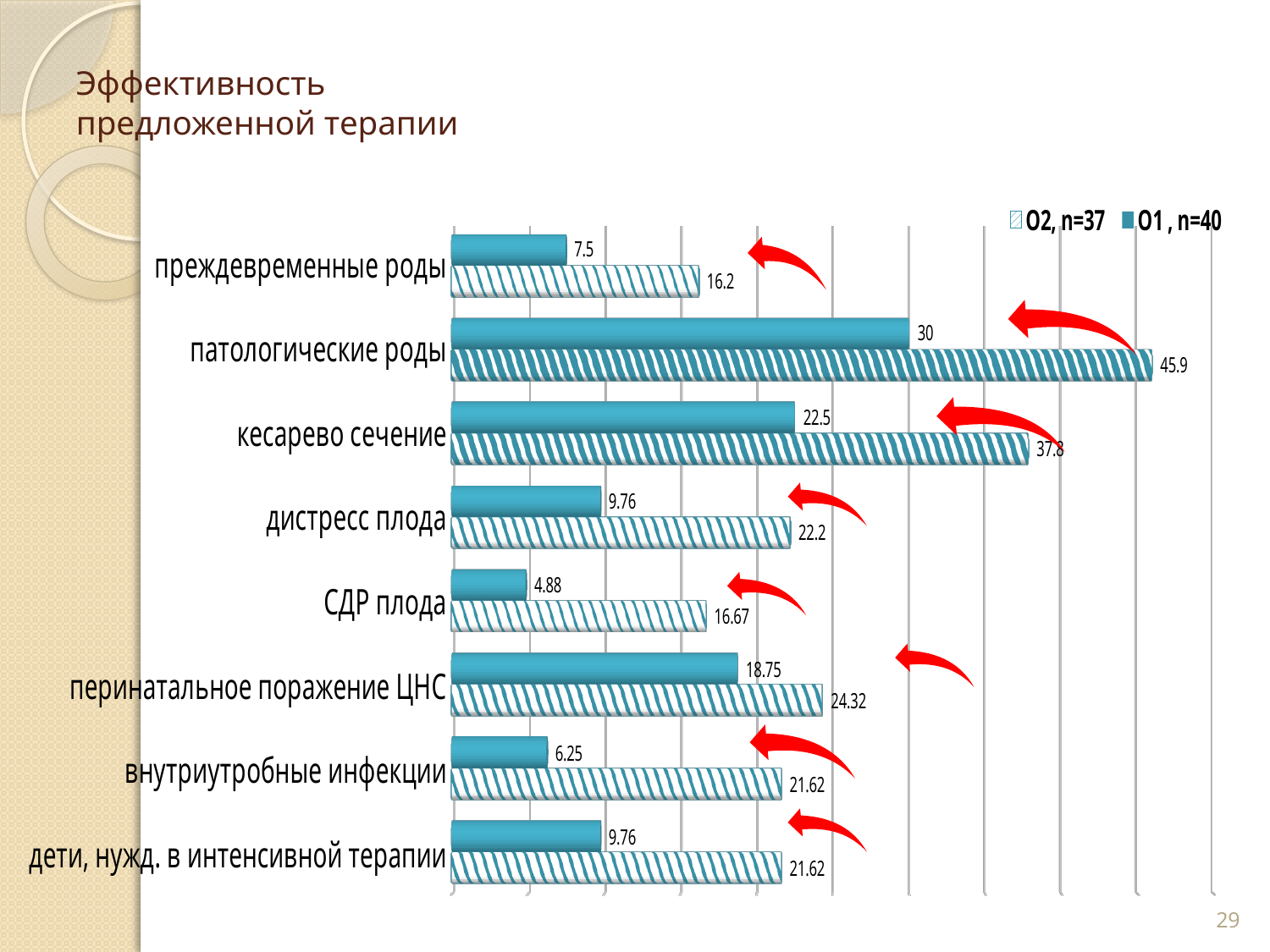
Which is larger for 'перинатальное поражение ЦНС': the O2, n=37 value or the O1, n=40 value? O2, n=37 What is the value for 'СДР плода' in the O1, n=40 series? 4.88 What is the difference between the O2, n=37 and O1, n=40 values for 'кесарево сечение'? 15.3 How many series does the legend list? 2 What is the title of the slide containing the chart? Эффективность предложенной терапии What is the value for 'внутриутробные инфекции' in the O2, n=37 series? 21.62 Which category has the highest value in the O1, n=40 series? патологические роды How many categories are shown on the chart? 8 What is the difference between the O2, n=37 and O1, n=40 values for 'преждевременные роды'? 8.7 What type of chart is shown on the slide? bar chart Which category has the lowest value in the O2, n=37 series? преждевременные роды What is the value for 'патологические роды' in the O2, n=37 series? 45.9